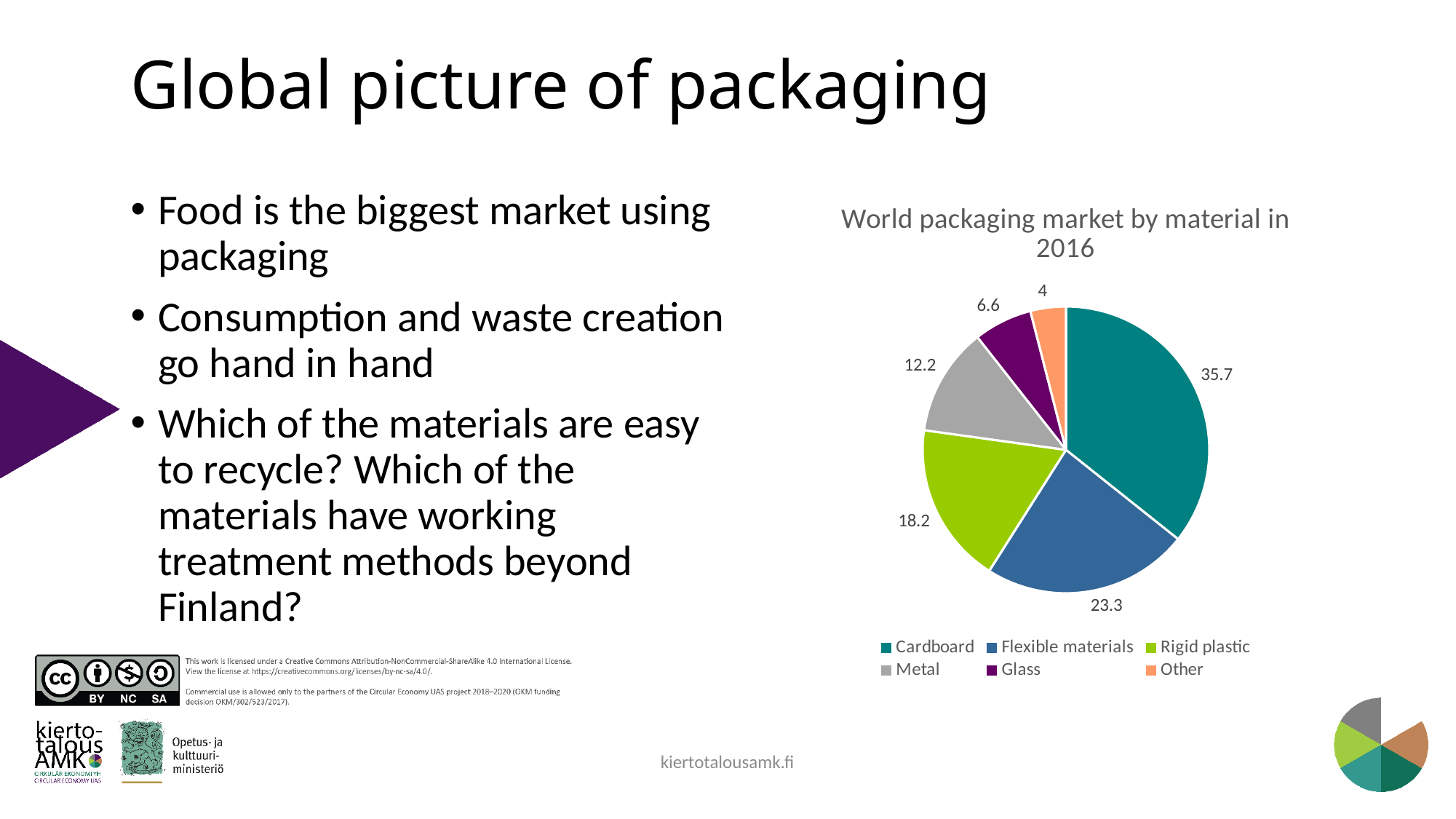
Which material has the largest slice of the pie chart? Cardboard What is the value for Glass in the pie chart? 6.6 What is the value for Cardboard in the pie chart? 35.7 What is the title of the chart? World packaging market by material in 2016 What colour is the Glass slice in the pie chart? Purple What is the difference between the values for Cardboard and Flexible materials? 12.4 Which is larger, the value for Rigid plastic or the value for Metal? Rigid plastic What is the value for Metal in the pie chart? 12.2 Which material has the smallest slice of the pie chart? Other What is the value for Flexible materials in the pie chart? 23.3 What type of chart is shown on the slide? Pie chart How many categories does the pie chart show? 6